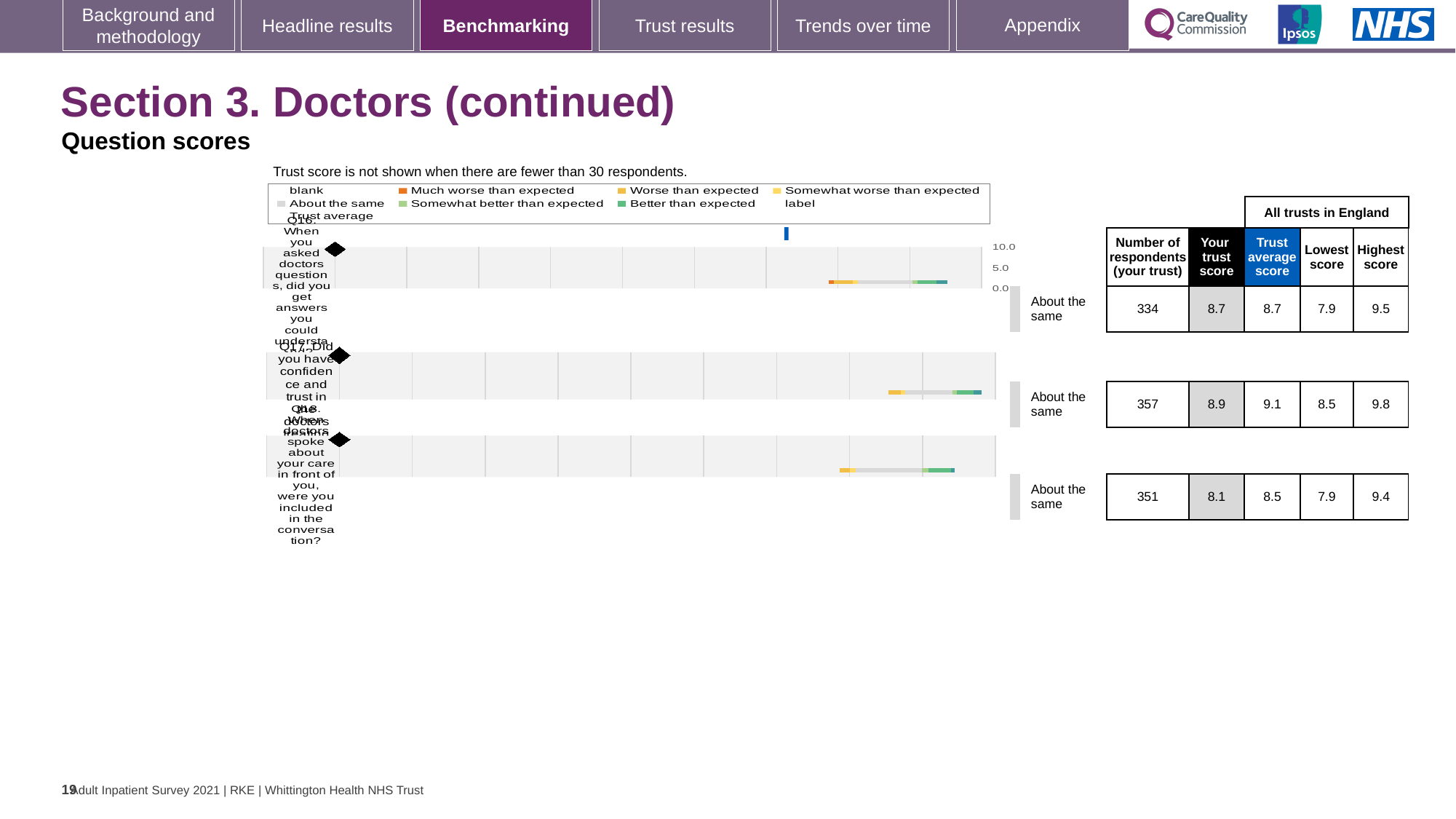
What is the trust average score for Q18? 8.5 What is the 'Your trust score' for Q17 (confidence and trust in the doctors)? 8.9 What is the difference between the highest score and the lowest score for Q18? 1.5 What kind of chart is used to show the question scores on this slide? bar chart How many respondents from your trust answered Q16? 334 What is the highest score across all trusts in England for Q17? 9.8 Which question has the highest 'Your trust score'? Q17 Which question has the lowest 'Your trust score'? Q18 What benchmark category is shown for Q16? About the same Which has the larger 'Your trust score', Q16 or Q18? Q16 How many questions are plotted in the chart? 3 What is the difference between the 'Your trust score' for Q17 and for Q16? 0.2